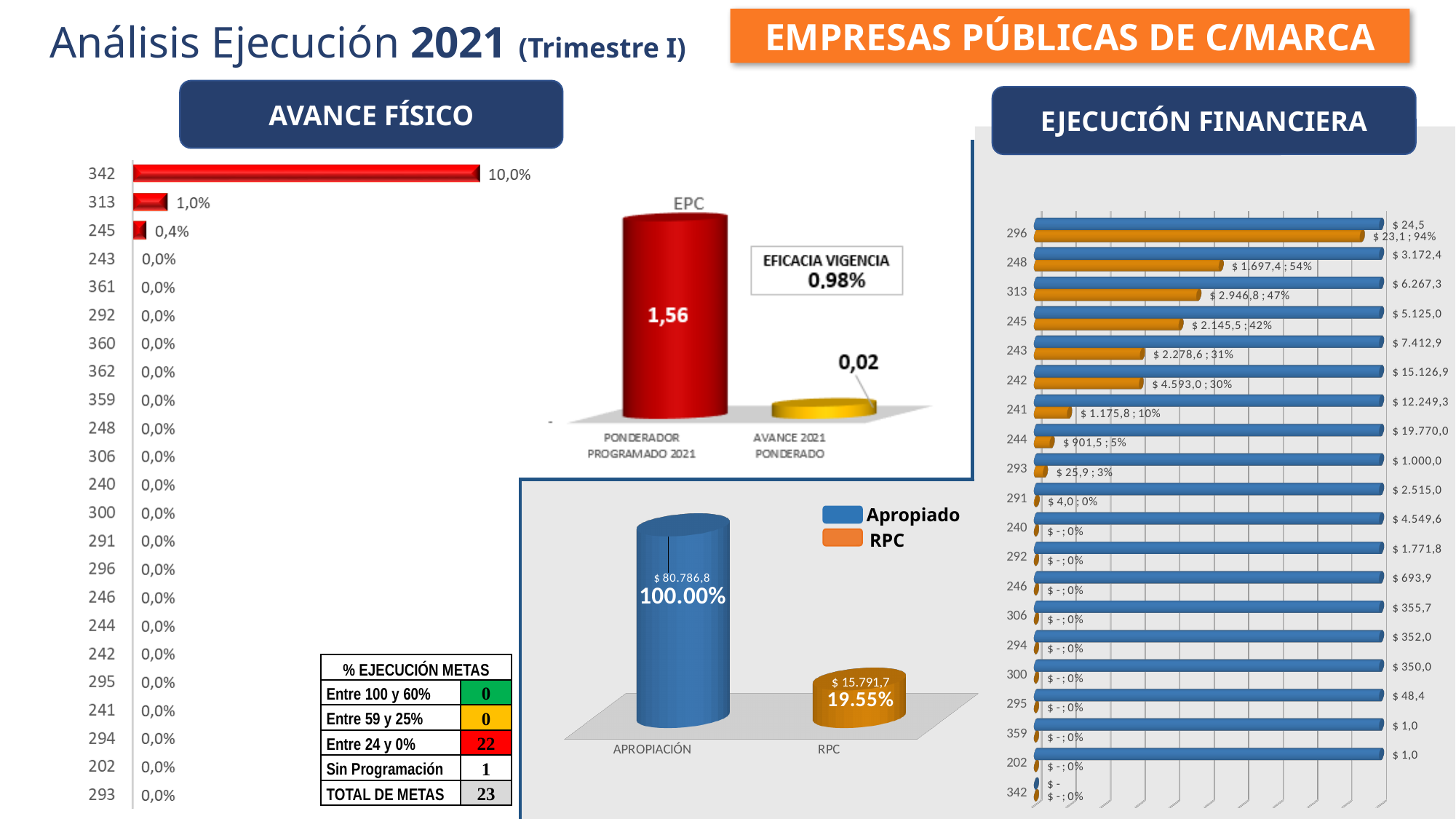
In the EJECUCIÓN FINANCIERA chart on the right, which category has the highest Apropiado value? 244 In the AVANCE FÍSICO chart on the left, what is the value for category 342? 10,0% In the AVANCE FÍSICO chart on the left, what is the value for category 313? 1,0% In the EJECUCIÓN FINANCIERA chart on the right, what is the Apropiado value for category 248? $ 3.172,4 What kind of chart is the AVANCE FÍSICO chart on the left? bar chart How many series does the legend of the APROPIACIÓN / RPC chart at the bottom centre list? 2 In the EJECUCIÓN FINANCIERA chart on the right, which is larger for category 296: the Apropiado value or the RPC value? Apropiado In the AVANCE FÍSICO chart on the left, which category has the highest value? 342 In the APROPIACIÓN / RPC chart at the bottom centre, what percentage is shown for RPC? 19.55% How many categories are plotted in the AVANCE FÍSICO chart on the left? 23 In the EPC chart, what is the value for PONDERADOR PROGRAMADO 2021? 1,56 In the EPC chart, what is the difference between PONDERADOR PROGRAMADO 2021 and AVANCE 2021 PONDERADO? 1,54